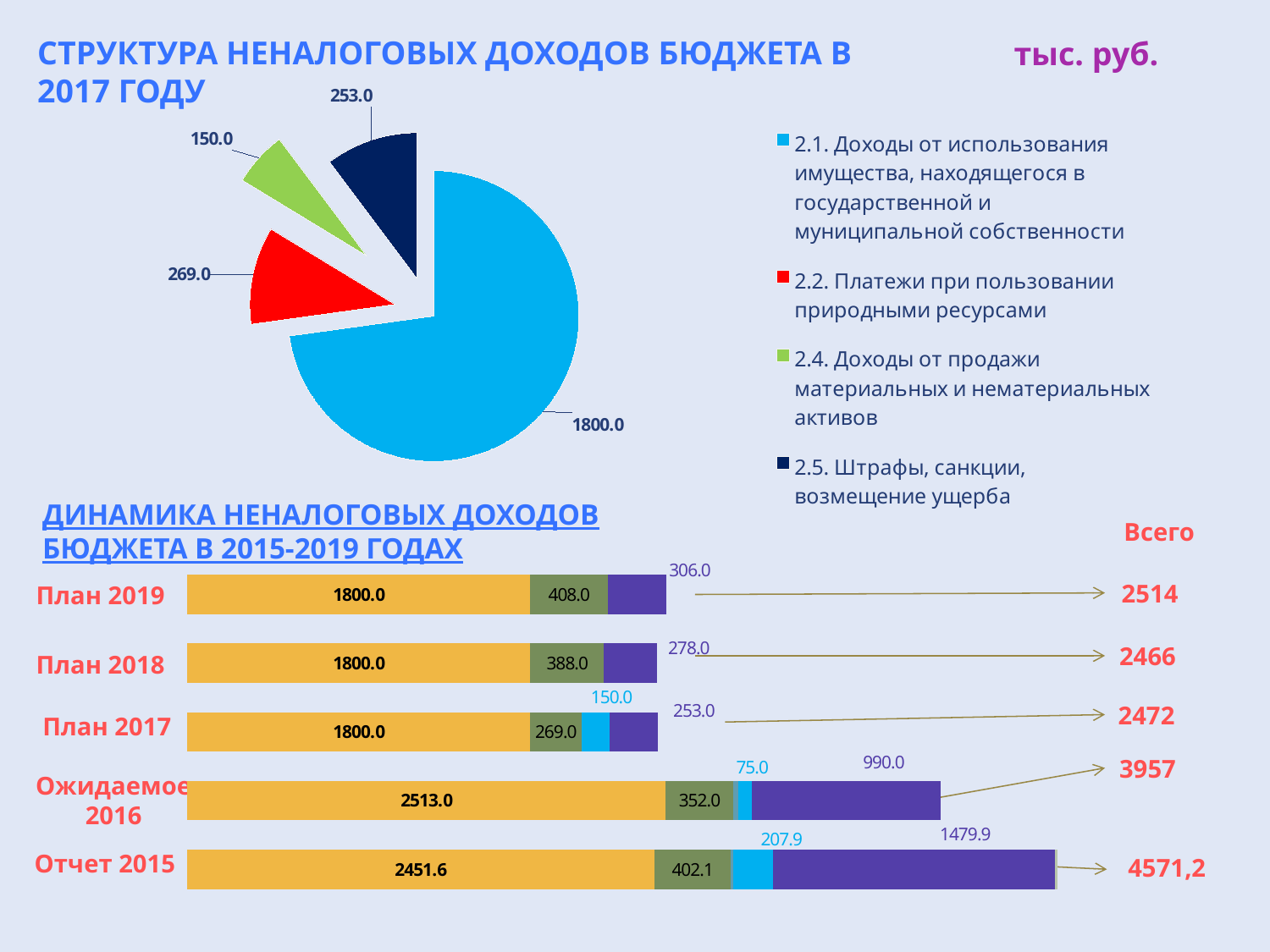
In the bottom bar chart, what is the total ('Всего') for 'Ожидаемое 2016'? 3957 What kind of chart is the bottom chart titled 'ДИНАМИКА НЕНАЛОГОВЫХ ДОХОДОВ БЮДЖЕТА В 2015-2019 ГОДАХ'? stacked bar chart In the pie chart, what is the difference between the value for '2.2. Платежи при пользовании природными ресурсами' and the value for '2.5. Штрафы, санкции, возмещение ущерба'? 16.0 What kind of chart is the top chart titled 'СТРУКТУРА НЕНАЛОГОВЫХ ДОХОДОВ БЮДЖЕТА В 2017 ГОДУ'? pie chart In the bottom bar chart, what is the value of the yellow segment for 'Отчет 2015'? 2451.6 In the pie chart, which category has the smallest value? 2.4. Доходы от продажи материальных и нематериальных активов In the bottom bar chart, how many categories are shown? 5 In the pie chart, how many slices are there? 4 In the bottom bar chart, which category has the largest total? Отчет 2015 In the pie chart, what share of the total does the slice for '2.1. Доходы от использования имущества, находящегося в государственной и муниципальной собственности' represent? 72.8% In the pie chart, what is the value for '2.5. Штрафы, санкции, возмещение ущерба'? 253.0 In the pie chart, what is the value for '2.2. Платежи при пользовании природными ресурсами'? 269.0